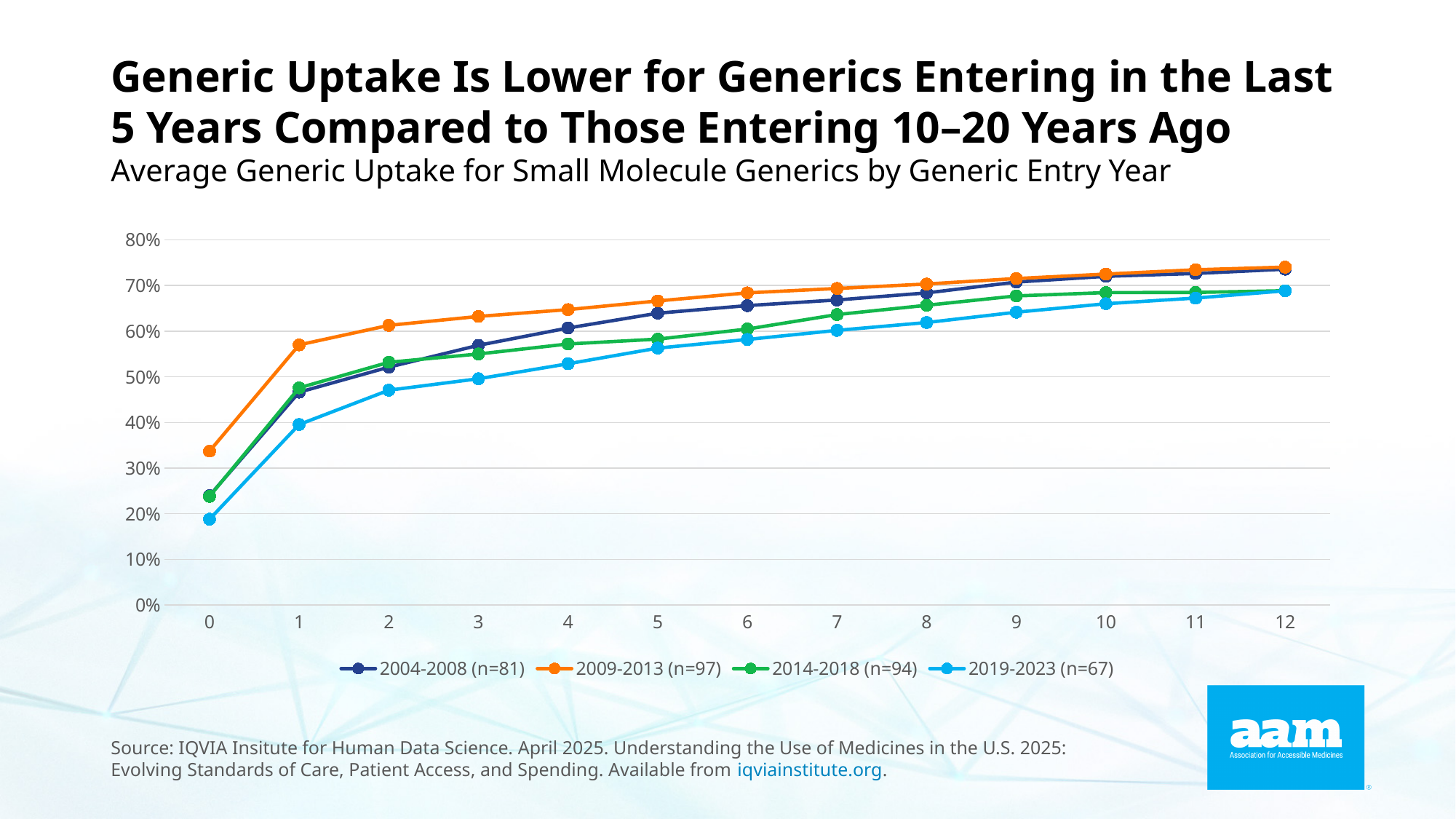
At x = 12, which is larger: the value for 2009-2013 (n=97) or the value for 2019-2023 (n=67)? 2009-2013 (n=97) How many points along the x axis does each line have? 13 Is the value for 2009-2013 (n=97) at x = 1 greater or less than 50%? greater What kind of chart is shown on the slide? line chart Do the values for 2019-2023 (n=67) rise or fall as x increases from 0 to 12? rise Is the value for 2019-2023 (n=67) at x = 2 greater or less than 50%? less Which series has the highest value at x = 0? 2009-2013 (n=97) Which series has the highest value at x = 1? 2009-2013 (n=97) How many series does the legend list? 4 Is the value for 2019-2023 (n=67) at x = 0 greater or less than 20%? less Which series has the lowest value at x = 0? 2019-2023 (n=67) What is the subtitle of the chart? Average Generic Uptake for Small Molecule Generics by Generic Entry Year